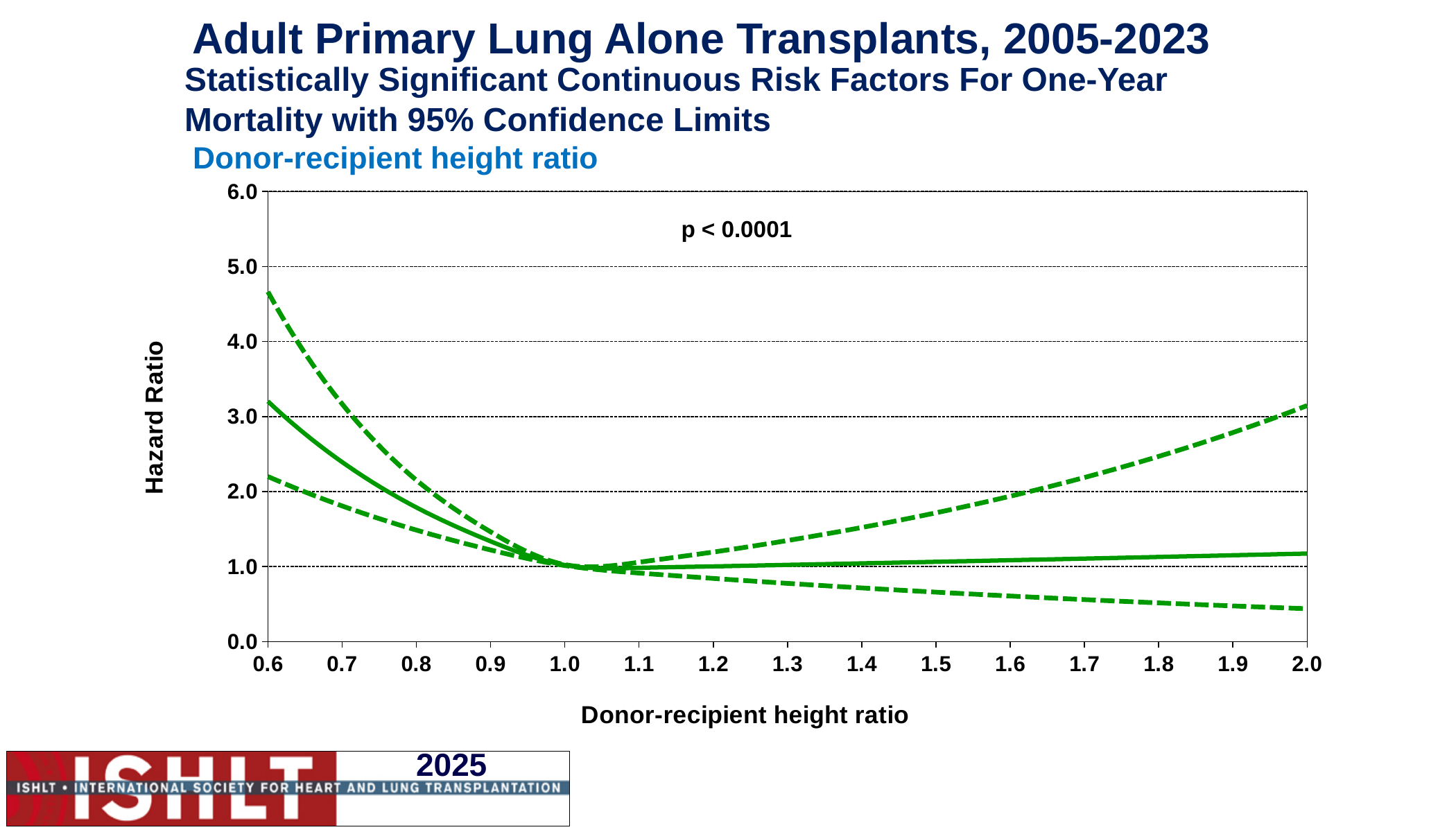
Does the lower dashed confidence limit rise or fall as the donor-recipient height ratio increases from 1.0 to 2.0? fall What kind of chart is shown on the slide? line chart Is the upper dashed confidence limit at a donor-recipient height ratio of 0.6 greater or less than 4.0? greater Is the lower dashed confidence limit at a donor-recipient height ratio of 2.0 greater or less than 1.0? less Does the solid hazard ratio line rise or fall as the donor-recipient height ratio increases from 0.6 to 1.0? fall What is the label of the y axis? Hazard Ratio Is the hazard ratio of the solid line at a donor-recipient height ratio of 0.6 greater or less than 2.0? greater What is the highest value shown on the y axis? 6.0 How many lines are plotted on the chart? 3 What p-value is printed on the chart? p < 0.0001 Does the upper dashed confidence limit rise or fall as the donor-recipient height ratio increases from 1.0 to 2.0? rise